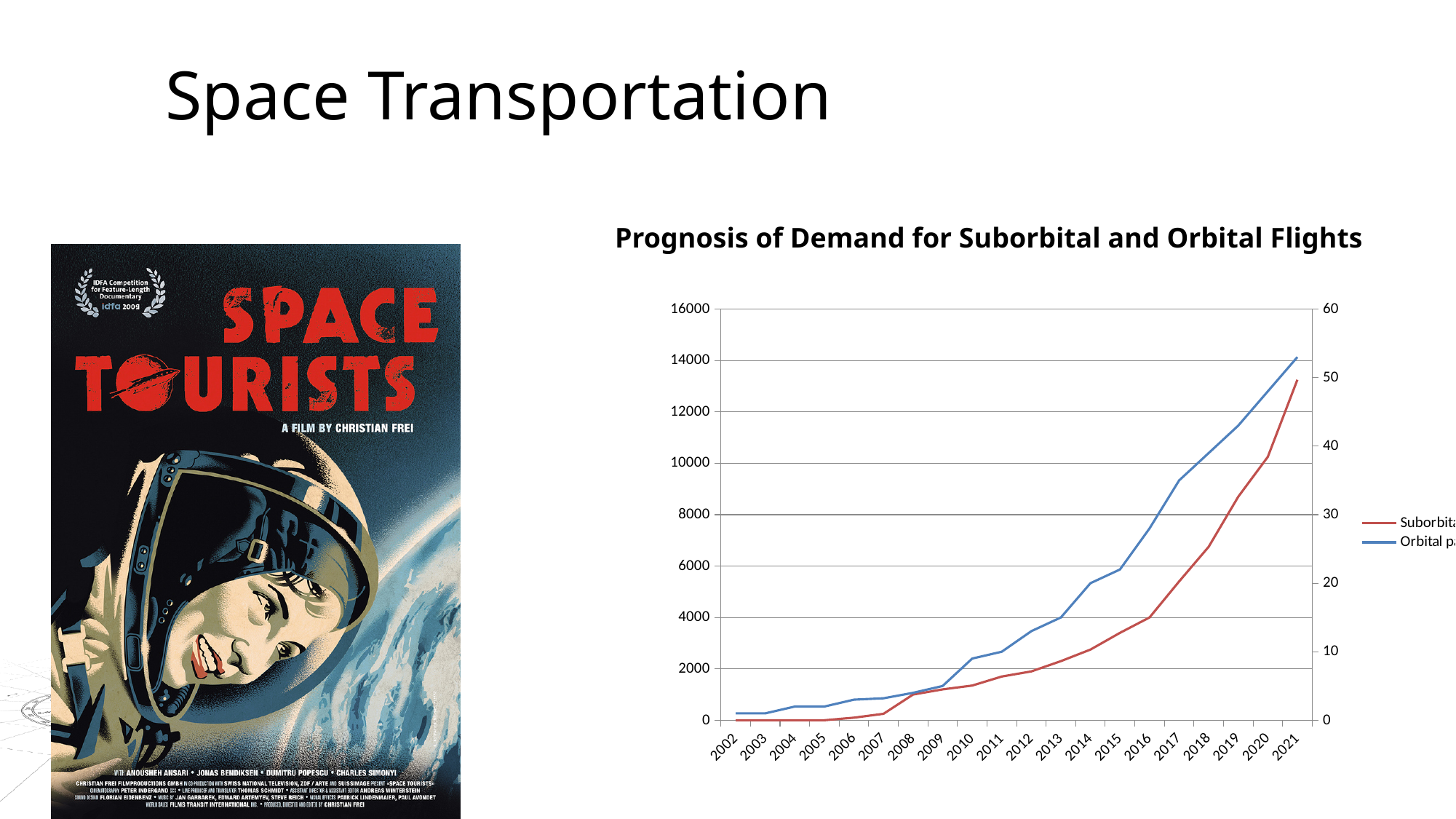
What kind of chart is shown on the slide? Line chart What is the maximum value shown on the right vertical axis of the chart? 60 Do the values of the Orbital series rise or fall from 2002 to 2021? Rise How many series does the chart's legend list? 2 Do the values of the Suborbital series rise or fall from 2002 to 2021? Rise What is the first year shown on the chart's x axis? 2002 What is the last year shown on the chart's x axis? 2021 What is the maximum value shown on the left vertical axis of the chart? 16000 How many years are plotted along the x axis of the chart? 20 In which year does the Suborbital series reach its highest point? 2021 What is the title of the chart on the slide? Prognosis of Demand for Suborbital and Orbital Flights What colour is the line for the Suborbital series? Red